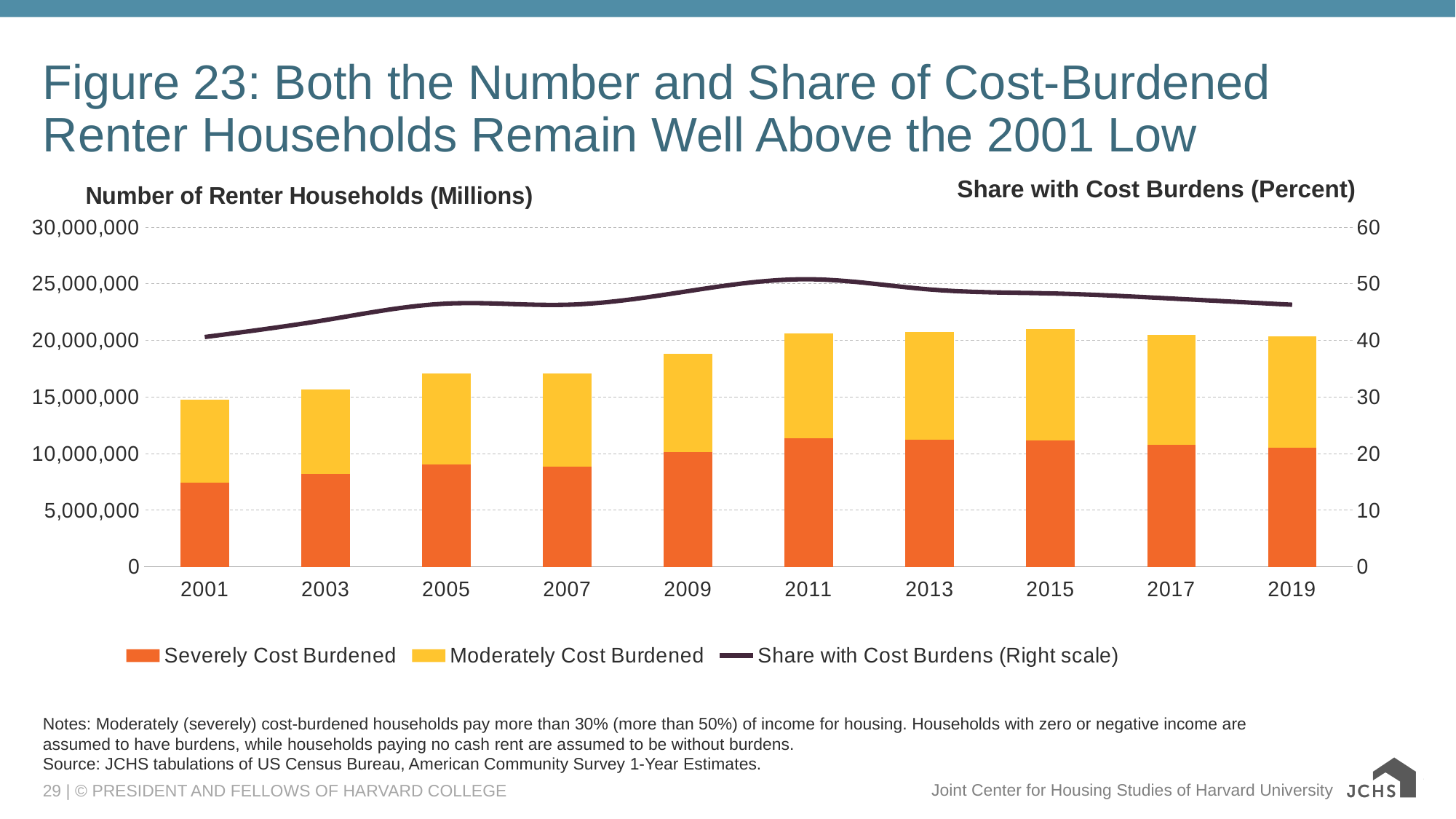
Which year has more Severely Cost Burdened renter households, 2001 or 2011? 2011 Is the total number of cost-burdened renter households in 2009 greater or less than 20,000,000? less Is the total number of cost-burdened renter households in 2015 greater or less than 20,000,000? greater In which year does the Share with Cost Burdens line reach its highest point? 2011 How many series does the chart's legend list? 3 What kind of chart is shown on the slide? A combined stacked bar and line chart Which axis does the Share with Cost Burdens line use, according to the legend? Right scale How many years are shown on the x axis of the chart? 10 Is the Share with Cost Burdens in 2019 greater or less than 50 percent? less Which year has a larger total of cost-burdened renter households, 2001 or 2009? 2009 In which year is the Share with Cost Burdens line at its lowest? 2001 Which year has the lowest total number of cost-burdened renter households? 2001